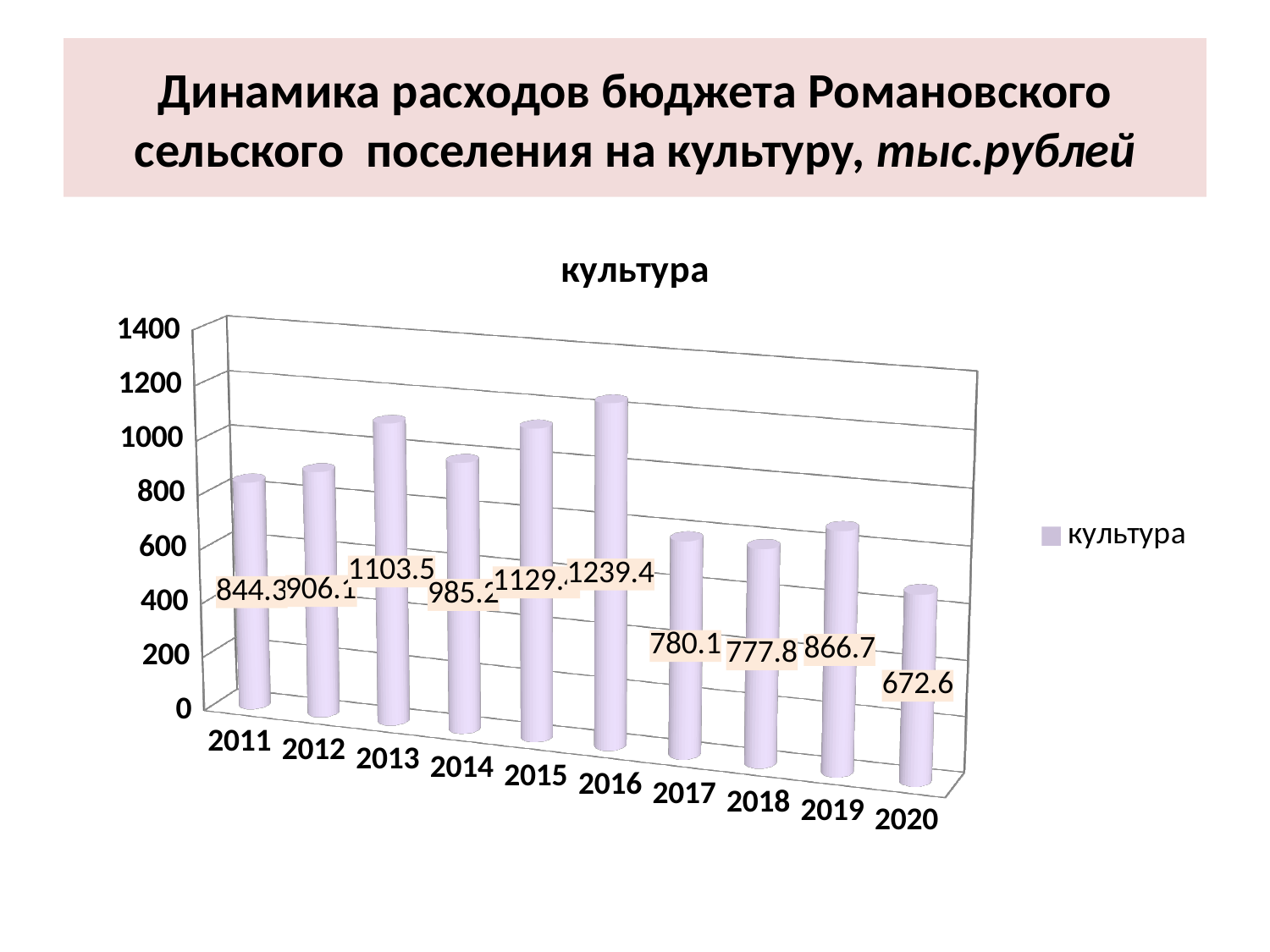
Which is larger, the value for 2019 or the value for 2018? 2019 Which year has the highest value? 2016 What is the value for 2011? 844.3 What is the value for 2020? 672.6 Is the value for 2015 greater or less than 1000? greater What is the value for 2013? 1103.5 How many years are shown on the x axis? 10 What is the value for 2017? 780.1 What kind of chart is this? bar chart What is the difference between the values for 2013 and 2014? 118.3 What is the title of the chart? культура Which year has the lowest value? 2020